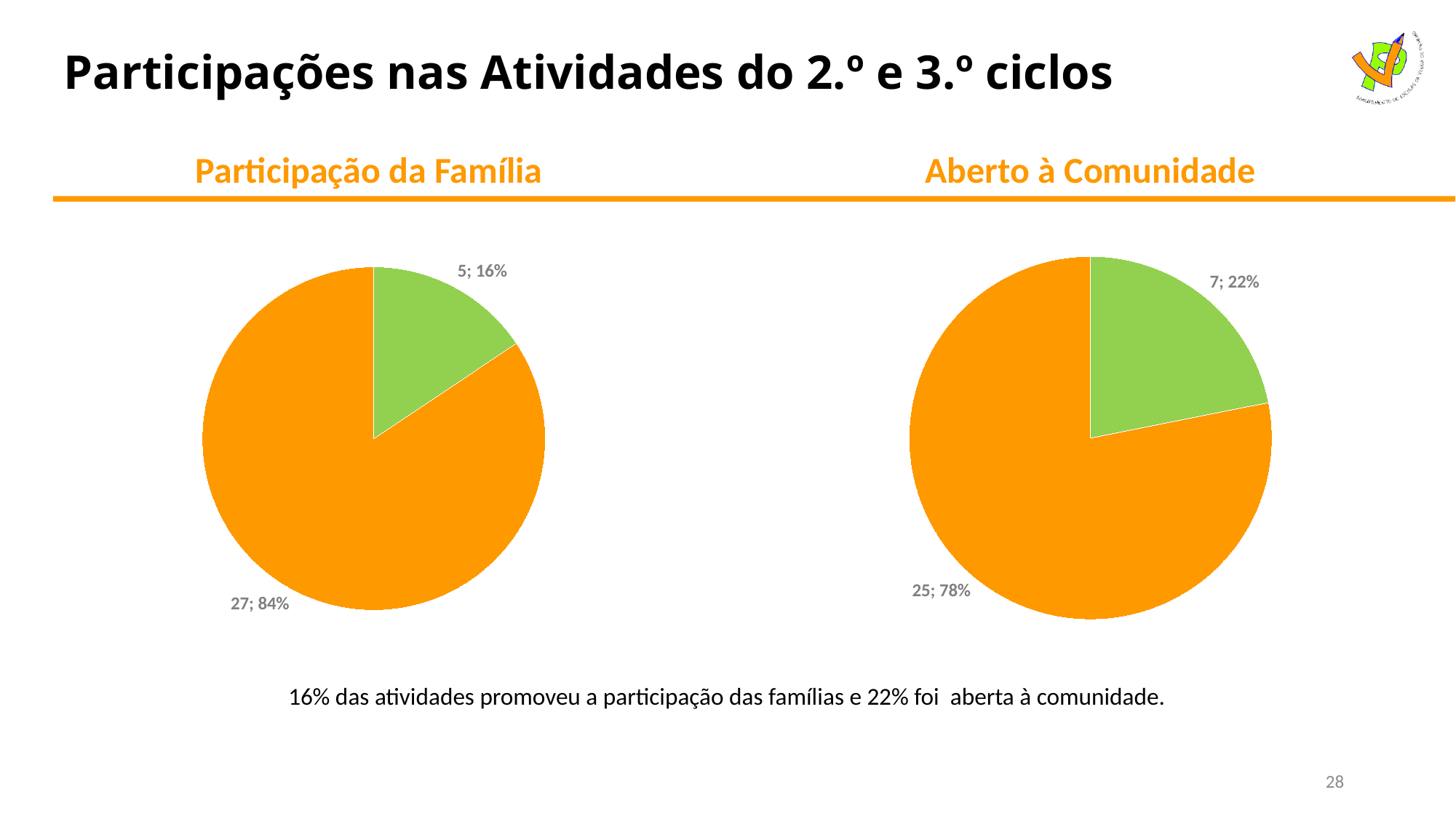
In the "Aberto à Comunidade" chart, which slice is the largest? The orange slice (25; 78%) How many slices does the "Aberto à Comunidade" pie chart have? 2 Which green slice has the larger count: the one in "Participação da Família" or the one in "Aberto à Comunidade"? Aberto à Comunidade In the "Participação da Família" chart, what is the data label on the orange slice? 27; 84% In the "Participação da Família" chart, what is the data label on the green slice? 5; 16% In the "Aberto à Comunidade" chart, what share of the pie does the orange slice represent? 78% What kind of chart is used under "Participação da Família"? Pie chart In the "Participação da Família" chart, what is the difference between the counts of the orange and green slices? 22 In the "Aberto à Comunidade" chart, what is the data label on the orange slice? 25; 78% In the "Aberto à Comunidade" chart, what is the data label on the green slice? 7; 22% In the "Participação da Família" chart, what share of the pie does the green slice represent? 16% In the "Participação da Família" chart, which slice is the smallest? The green slice (5; 16%)